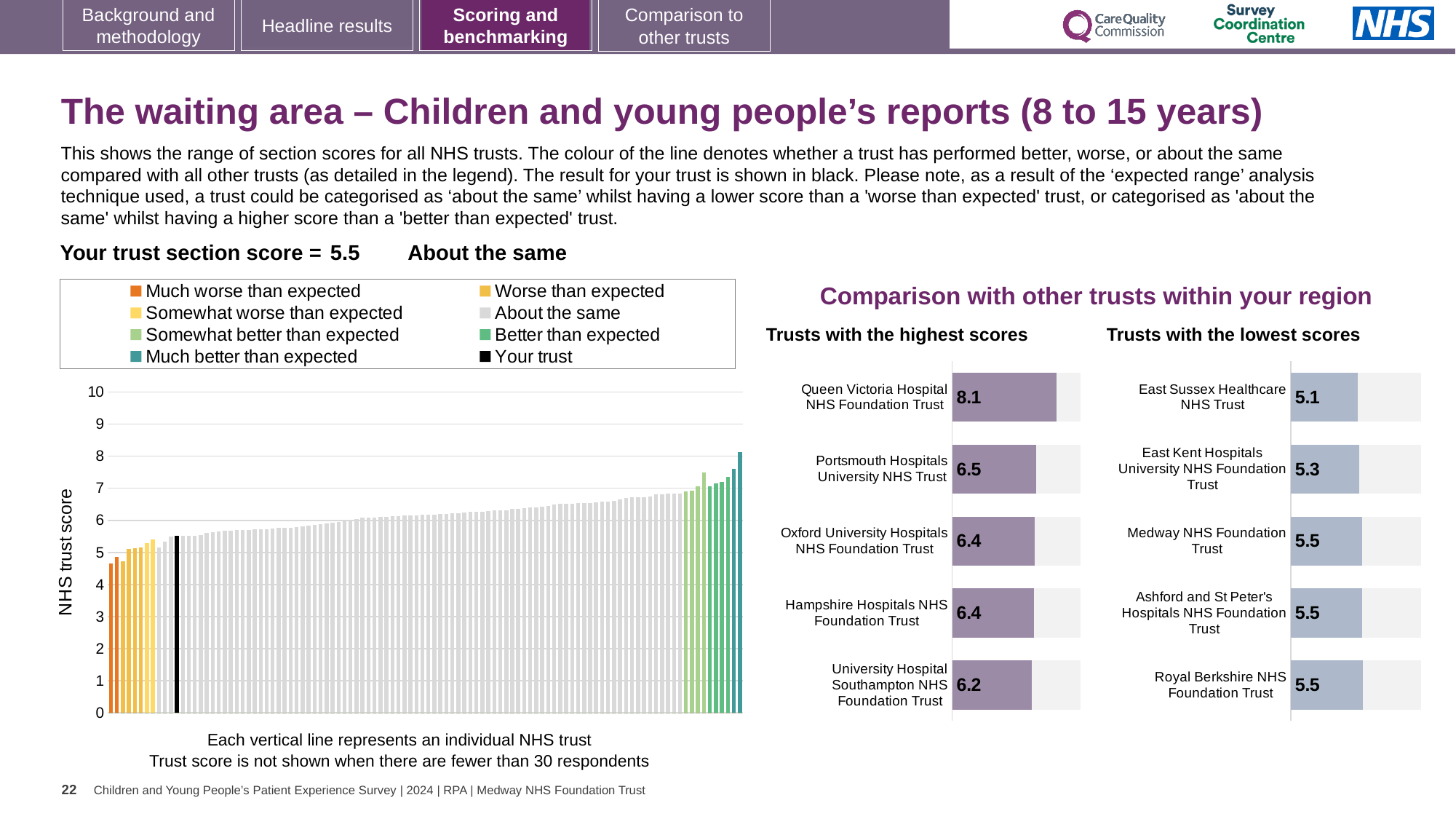
In the NHS trust score chart on the left, do the bar values rise or fall from left to right? Rise In the 'Trusts with the lowest scores' chart, which trust has the lowest score? East Sussex Healthcare NHS Trust In the 'Trusts with the lowest scores' chart, what is the difference between the scores of Medway NHS Foundation Trust and East Sussex Healthcare NHS Trust? 0.4 How many entries does the legend of the NHS trust score chart list? 8 Which has a higher score: Portsmouth Hospitals University NHS Trust in the 'highest scores' chart or East Kent Hospitals University NHS Foundation Trust in the 'lowest scores' chart? Portsmouth Hospitals University NHS Trust In the 'Trusts with the lowest scores' chart, what is the score for East Kent Hospitals University NHS Foundation Trust? 5.3 What kind of chart is the NHS trust score chart on the left? Bar chart In the NHS trust score chart on the left, is the value of the lowest bar greater or less than 5? less In the 'Trusts with the highest scores' chart, how many trusts are shown? 5 In the 'Trusts with the highest scores' chart, what is the score for Queen Victoria Hospital NHS Foundation Trust? 8.1 In the 'Trusts with the highest scores' chart, what is the difference between the scores of Queen Victoria Hospital NHS Foundation Trust and University Hospital Southampton NHS Foundation Trust? 1.9 In the 'Trusts with the highest scores' chart, which trust has the highest score? Queen Victoria Hospital NHS Foundation Trust